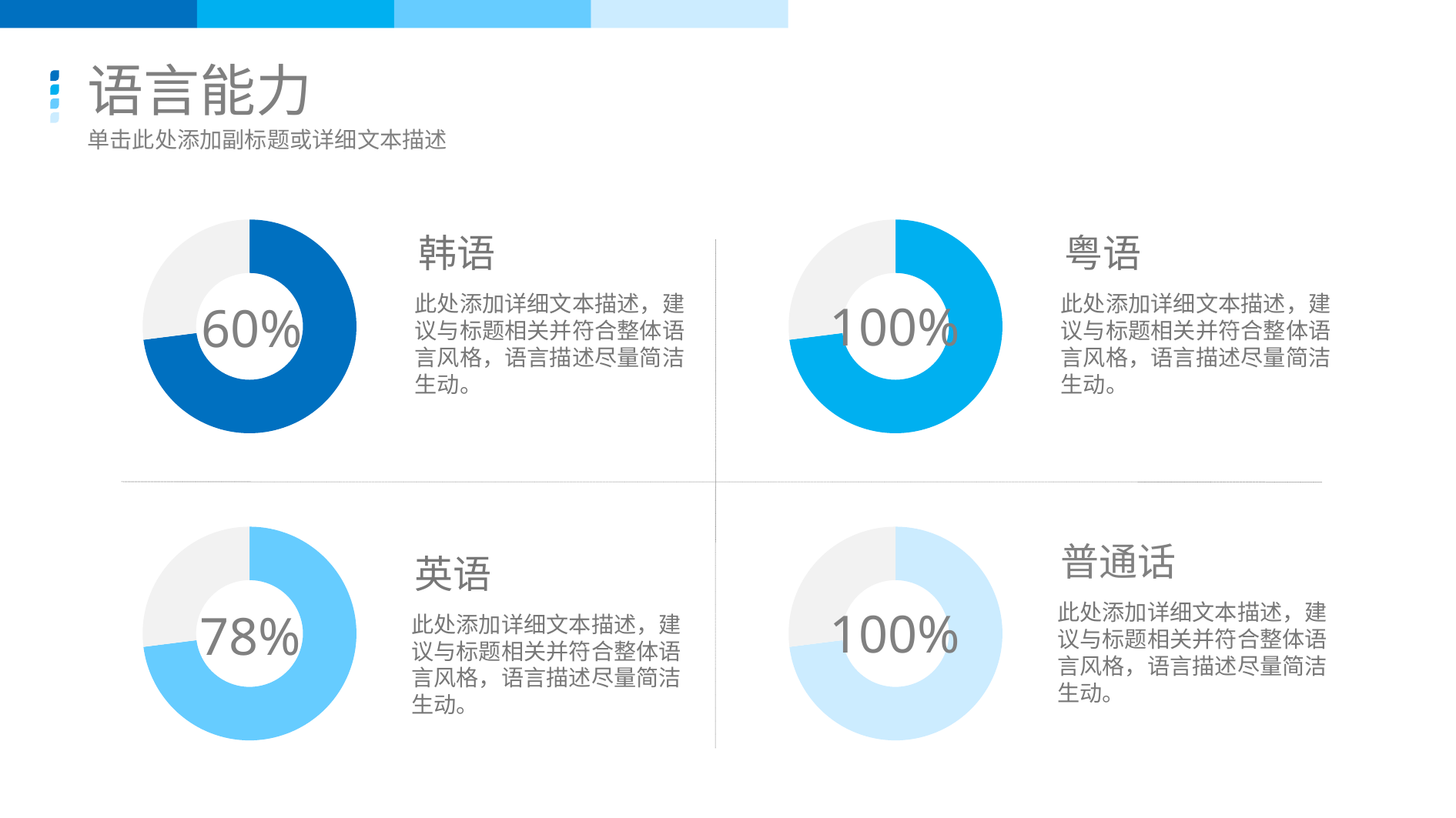
What kind of chart is used for each language on the slide? Donut chart How many languages show a value of 100%? 2 Which is larger, the percentage shown for 英语 or for 韩语? 英语 What is the title of the slide? 语言能力 Which language has the lowest percentage shown on the slide? 韩语 What percentage is shown in the donut chart for 粤语? 100% What percentage is shown in the donut chart for 英语? 78% What is the difference between the percentages shown for 英语 and 韩语? 18% Which language's donut chart is drawn in the darkest blue? 韩语 What percentage is shown in the donut chart for 韩语? 60% What percentage is shown in the donut chart for 普通话? 100% How many donut charts are on the slide? 4